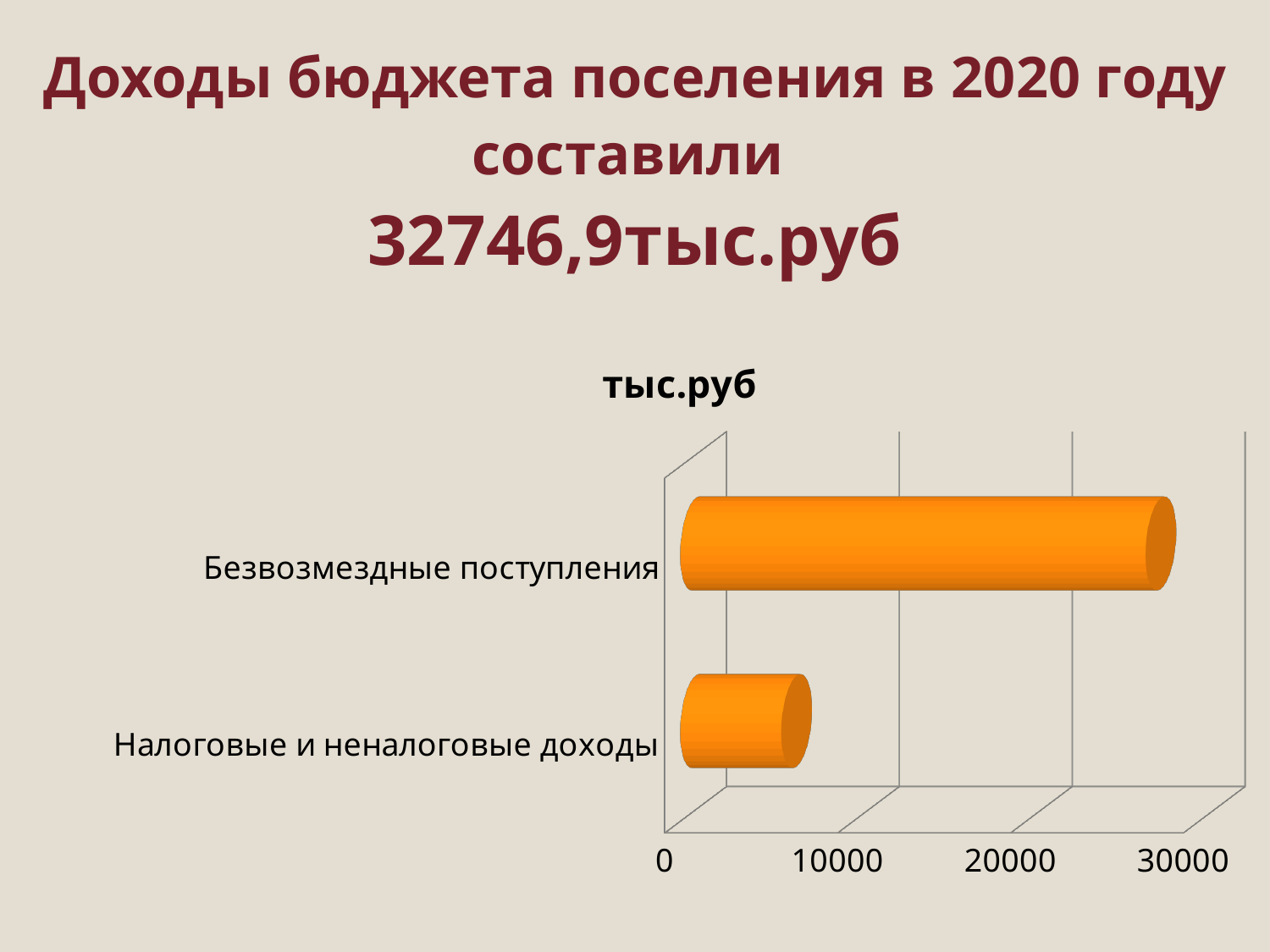
Which is larger: Безвозмездные поступления or Налоговые и неналоговые доходы? Безвозмездные поступления Which category has the lowest value in the chart? Налоговые и неналоговые доходы How many categories are plotted in the chart? 2 Is the value for Налоговые и неналоговые доходы greater or less than 10000? less Is the value for Безвозмездные поступления greater or less than 10000? greater What is the highest value shown on the chart's horizontal axis? 30000 Is the value for Безвозмездные поступления greater or less than 20000? greater Which category has the highest value in the chart? Безвозмездные поступления What kind of chart is shown on the slide? bar chart What is the title of the chart? тыс.руб